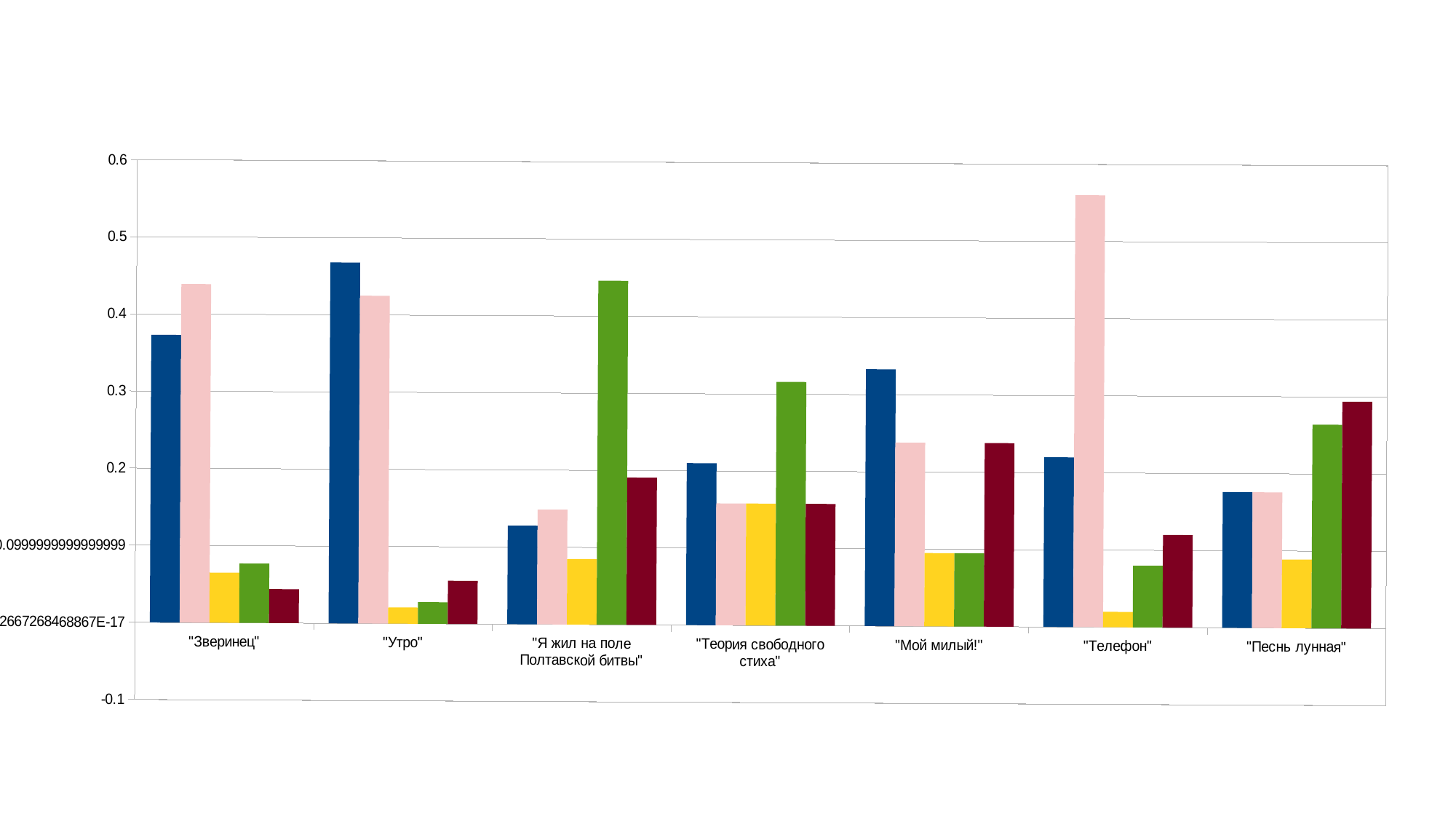
For "Зверинец", which is taller: the dark blue bar or the pink bar? the pink bar Is the value of the dark blue bar for "Мой милый!" greater or less than 0.3? greater How many categories are shown along the x axis of the chart? 7 Is the value of the green bar for "Я жил на поле Полтавской битвы" greater or less than 0.4? greater Which category contains the tallest bar in the chart? "Телефон" Is the value of the yellow bar for "Телефон" greater or less than 0.1? less What kind of chart is shown on the slide? bar chart For "Утро", which is taller: the dark blue bar or the pink bar? the dark blue bar Does the chart include a legend identifying the series? No How many bars are plotted for each category in the chart? 5